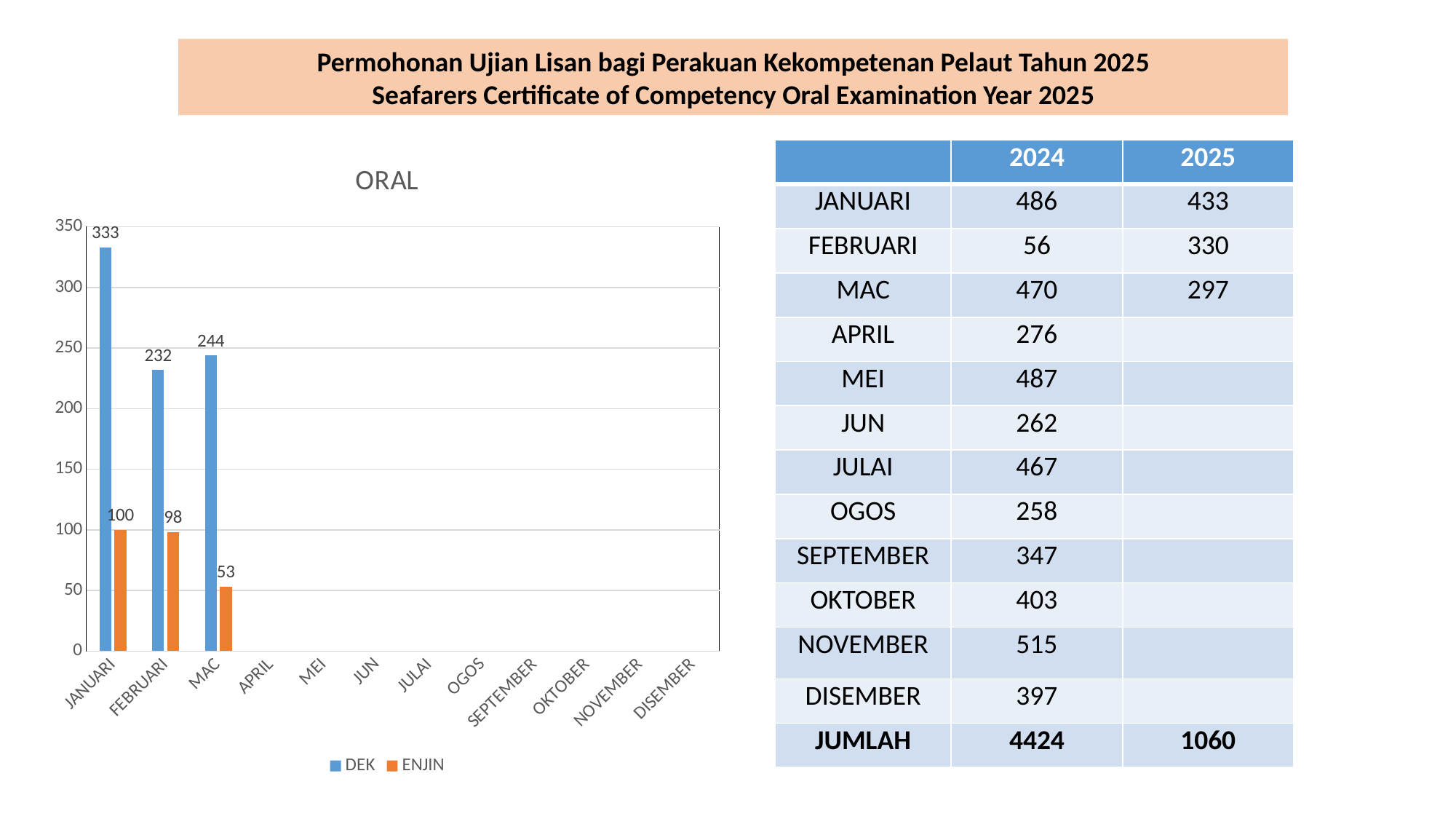
Is the DEK value for JANUARI greater or less than 300 in the ORAL chart? greater What is the DEK value for FEBRUARI in the ORAL chart? 232 How many month categories are shown on the x axis of the ORAL chart? 12 What is the ENJIN value for MAC in the ORAL chart? 53 Is the DEK value for MAC larger than the DEK value for FEBRUARI in the ORAL chart? Yes Which month has the highest DEK value in the ORAL chart? JANUARI Which month has the lowest ENJIN value among the months with plotted bars in the ORAL chart? MAC What is the DEK value for JANUARI in the ORAL chart? 333 How many series does the legend of the ORAL chart list? 2 What is the difference between the DEK values for MAC and FEBRUARI in the ORAL chart? 12 What is the difference between the DEK and ENJIN values for JANUARI in the ORAL chart? 233 What type of chart is the ORAL chart? Bar chart